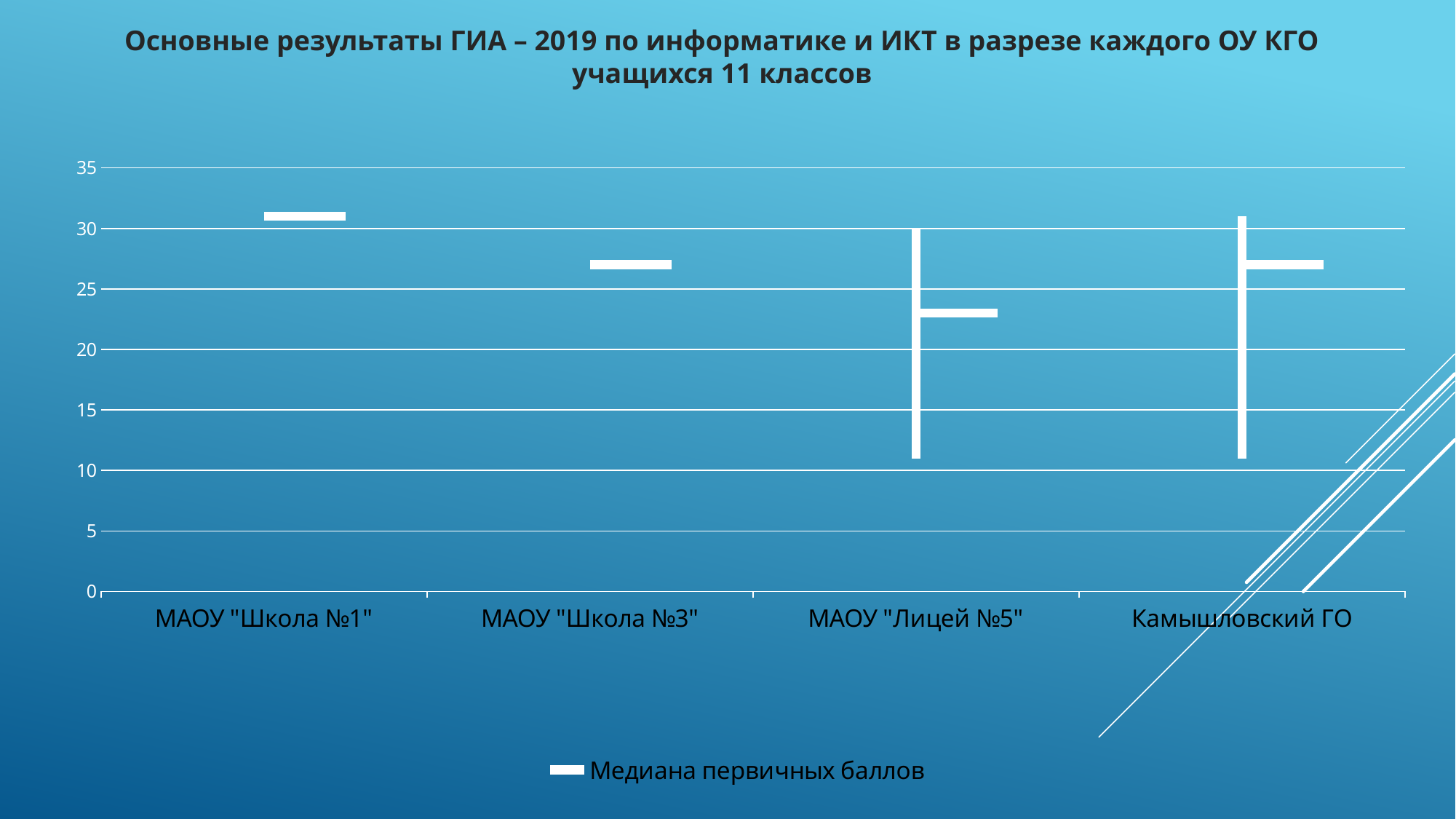
Is the median value for МАОУ "Лицей №5" greater or less than 25? less Which category has the lowest median marker on the chart? МАОУ "Лицей №5" What is the name of the series shown in the chart legend? Медиана первичных баллов Is the median value for МАОУ "Лицей №5" greater or less than 20? greater What is the highest value shown on the vertical axis of the chart? 35 Is the median value for Камышловский ГО greater or less than 30? less How many categories are shown on the x axis of the chart? 4 Which category has the highest median marker on the chart? МАОУ "Школа №1" How many series does the chart legend list? 1 Which has a higher median value: МАОУ "Школа №1" or МАОУ "Лицей №5"? МАОУ "Школа №1"